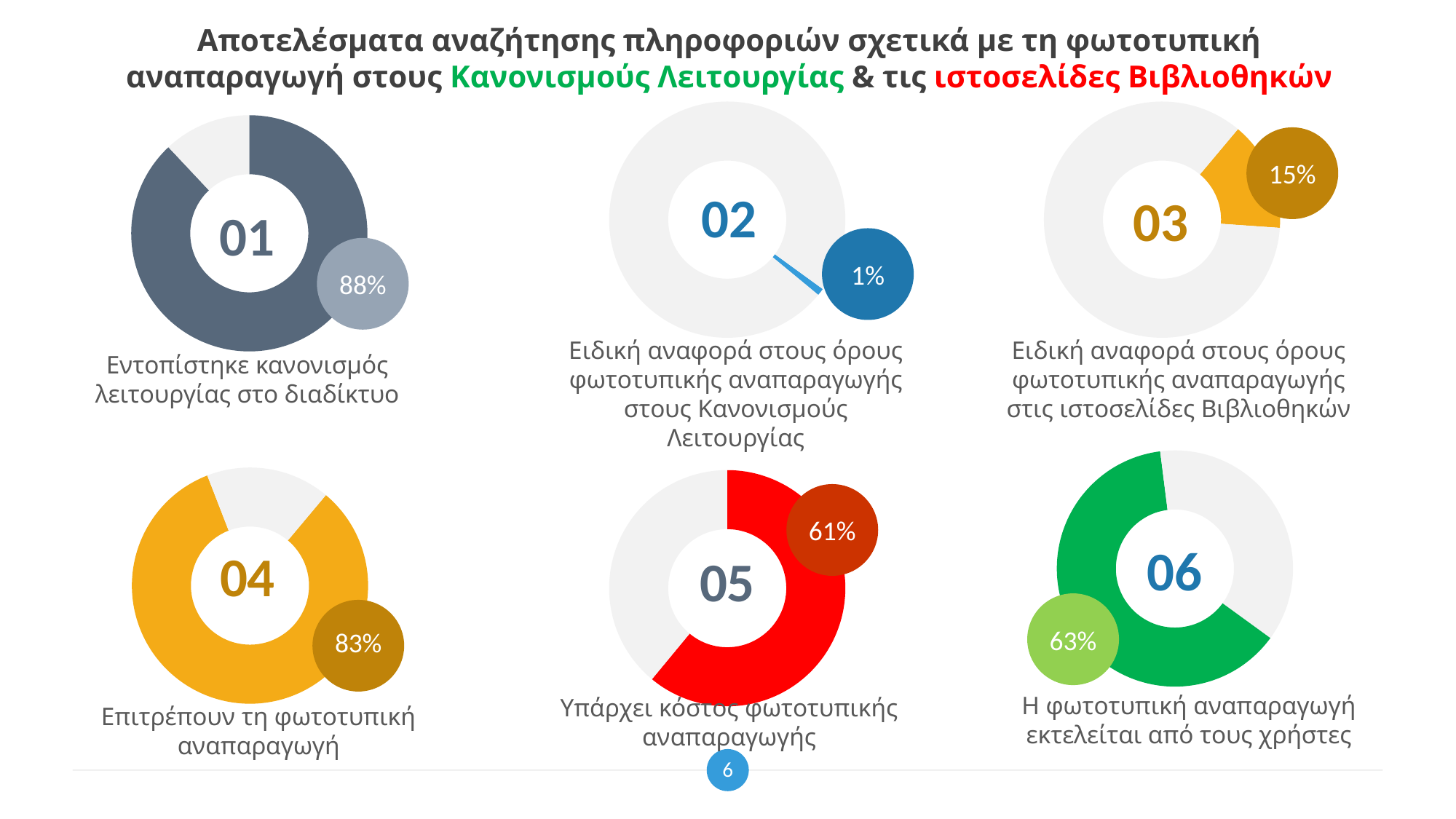
What percentage is shown on donut chart 01 (Εντοπίστηκε κανονισμός λειτουργίας στο διαδίκτυο)? 88% Which is larger: the percentage on chart 05 or the percentage on chart 06? Chart 06 (63%) Across the six donut charts on the slide, which chart shows the lowest percentage? 02 (1%) What percentage is shown on donut chart 03 (Ειδική αναφορά στους όρους φωτοτυπικής αναπαραγωγής στις ιστοσελίδες Βιβλιοθηκών)? 15% Across the six donut charts on the slide, which chart shows the highest percentage? 01 (88%) What percentage is shown on donut chart 04 (Επιτρέπουν τη φωτοτυπική αναπαραγωγή)? 83% What percentage is shown on donut chart 05 (Υπάρχει κόστος φωτοτυπικής αναπαραγωγής)? 61% What percentage is shown on donut chart 02 (Ειδική αναφορά στους όρους φωτοτυπικής αναπαραγωγής στους Κανονισμούς Λειτουργίας)? 1% How many donut charts are shown on the slide? 6 What percentage is shown on donut chart 06 (Η φωτοτυπική αναπαραγωγή εκτελείται από τους χρήστες)? 63% What type of chart is used for each of the six figures on the slide? Donut chart What is the difference between the percentage on chart 01 and the percentage on chart 04? 5%